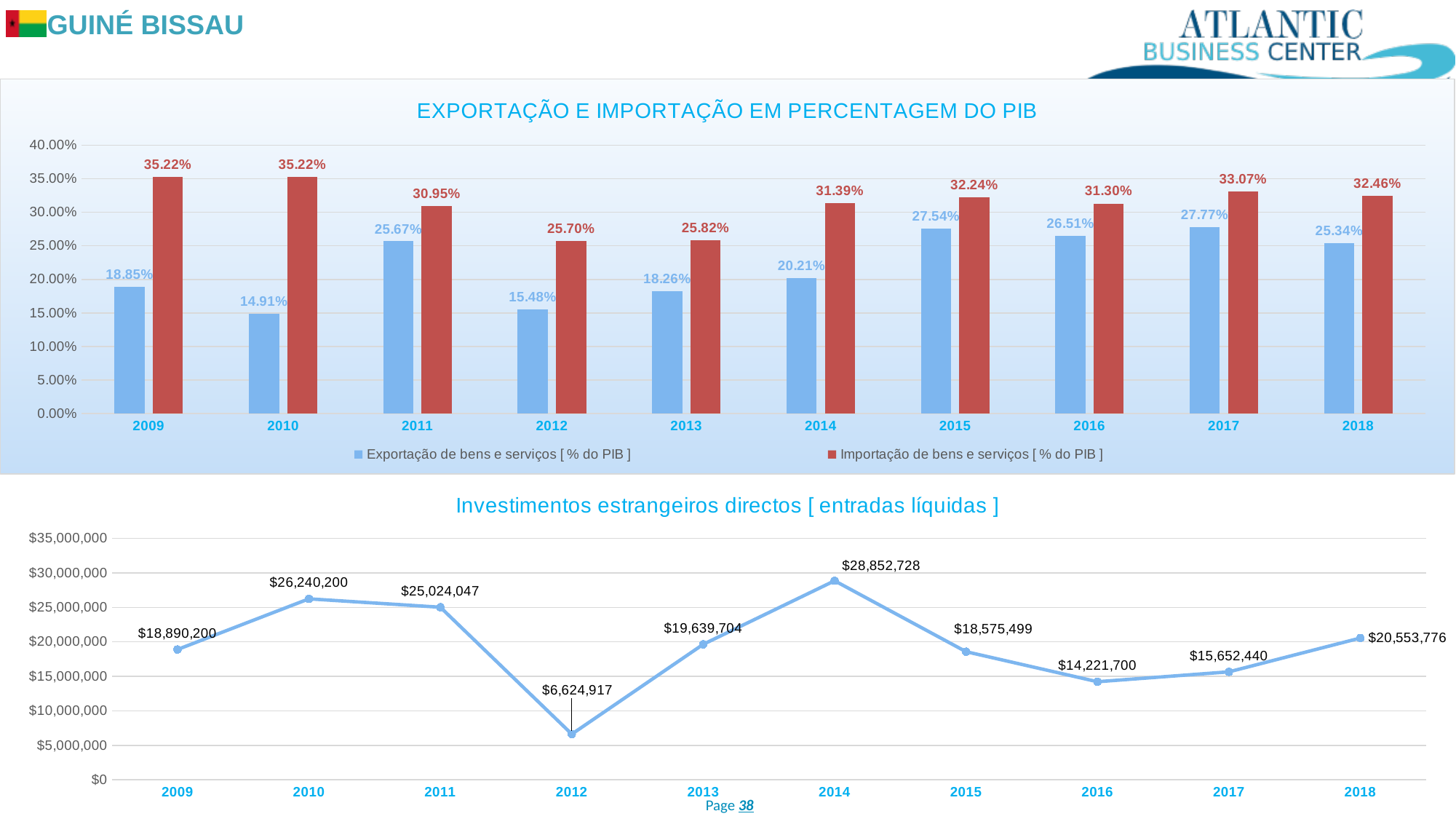
In the top chart (EXPORTAÇÃO E IMPORTAÇÃO EM PERCENTAGEM DO PIB), what is the difference between Importação and Exportação in 2009? 16.37% In the bottom chart (Investimentos estrangeiros directos), which year has the lowest value? 2012 In the top chart (EXPORTAÇÃO E IMPORTAÇÃO EM PERCENTAGEM DO PIB), how many series does the legend list? 2 In the bottom chart (Investimentos estrangeiros directos), what is the difference between the 2010 and 2009 values? $7,350,000 In the bottom chart (Investimentos estrangeiros directos), which year has the highest value? 2014 In the top chart (EXPORTAÇÃO E IMPORTAÇÃO EM PERCENTAGEM DO PIB), what is the value of Importação de bens e serviços for 2017? 33.07% In the top chart (EXPORTAÇÃO E IMPORTAÇÃO EM PERCENTAGEM DO PIB), what is the value of Exportação de bens e serviços for 2011? 25.67% In the bottom chart (Investimentos estrangeiros directos), what is the value for 2016? $14,221,700 In the top chart (EXPORTAÇÃO E IMPORTAÇÃO EM PERCENTAGEM DO PIB), which is larger in 2014: Exportação or Importação? Importação What kind of chart is the top chart (EXPORTAÇÃO E IMPORTAÇÃO EM PERCENTAGEM DO PIB)? Bar chart In the bottom chart (Investimentos estrangeiros directos), how many years are plotted? 10 In the top chart (EXPORTAÇÃO E IMPORTAÇÃO EM PERCENTAGEM DO PIB), which year has the lowest Exportação de bens e serviços value? 2010